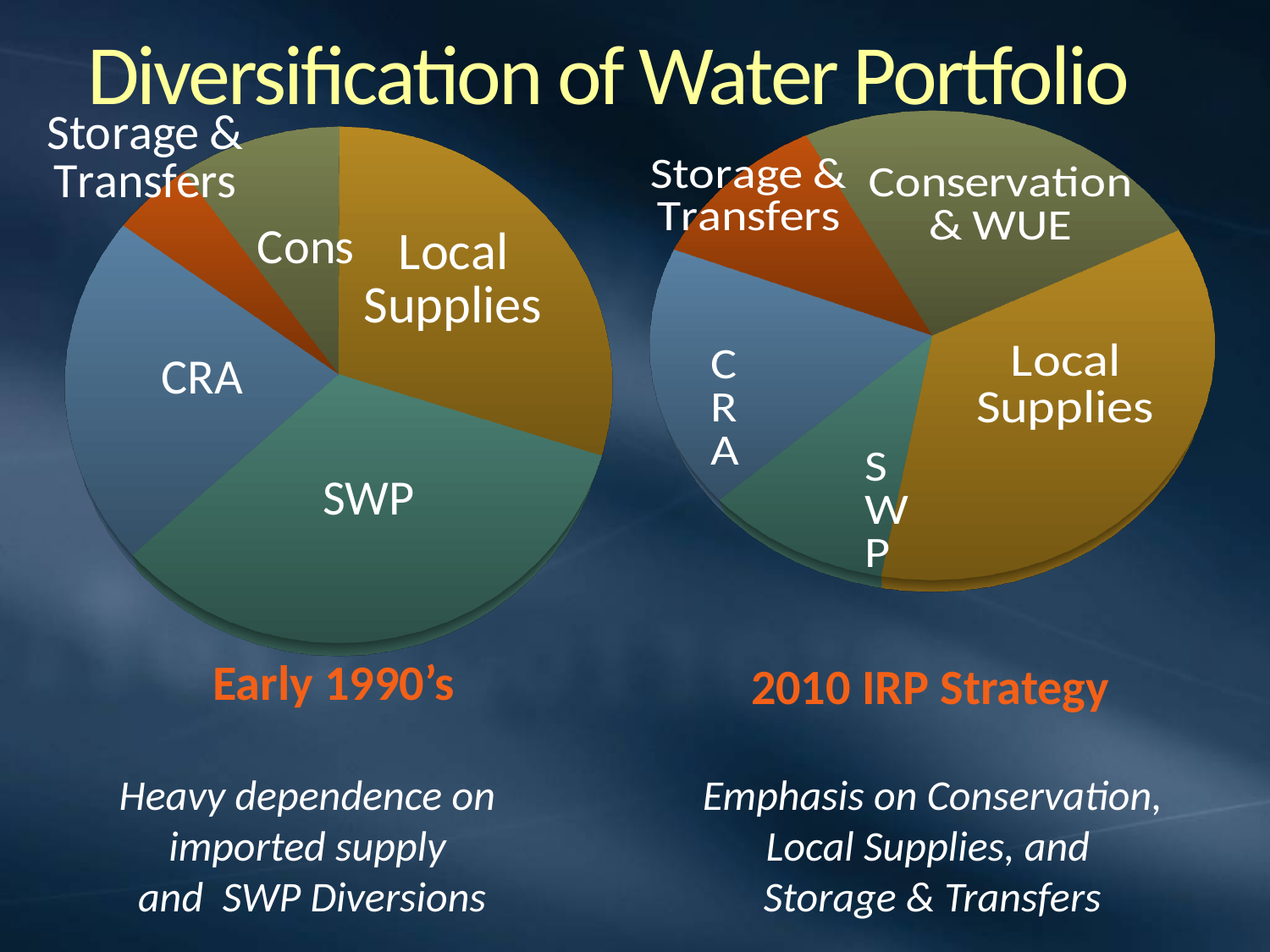
How many slices does the 2010 IRP Strategy pie chart have? 5 In the Early 1990's chart, which slice is larger: SWP or Cons? SWP In the Early 1990's chart, which slice is larger: CRA or Storage & Transfers? CRA How many pie charts are shown on the slide? 2 How many slices does the Early 1990's pie chart have? 5 What is the label under the right-hand pie chart? 2010 IRP Strategy In the 2010 IRP Strategy chart, which category has the largest slice? Local Supplies In the 2010 IRP Strategy chart, which slice is larger: Conservation & WUE or Storage & Transfers? Conservation & WUE What kind of chart is the Early 1990's chart? pie chart